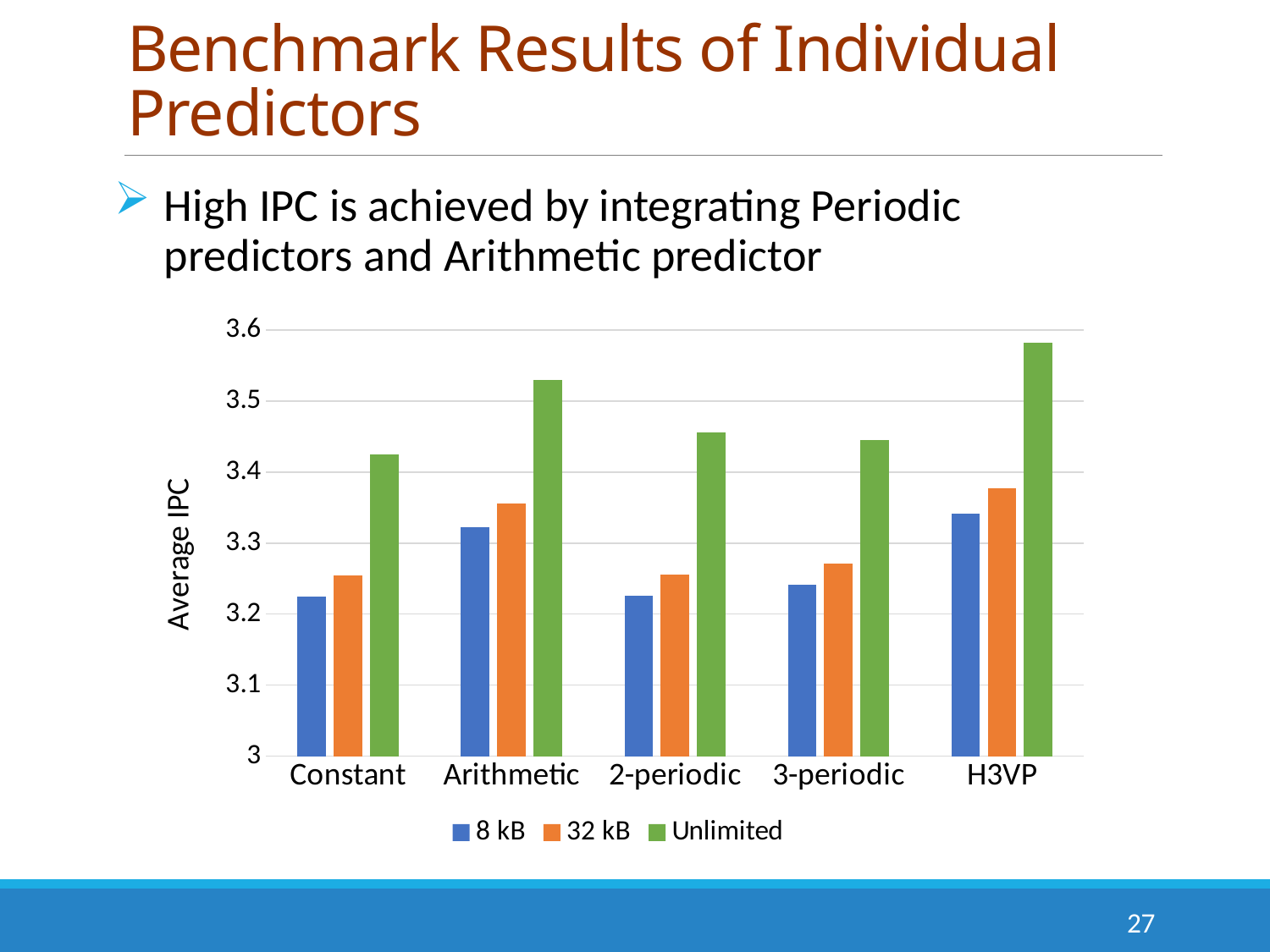
Is the 32 kB value for H3VP greater or less than 3.4? less Is the 8 kB value for Arithmetic greater or less than 3.3? greater What is the label of the vertical axis? Average IPC Is the Unlimited value for H3VP greater or less than 3.5? greater Which is larger, the 8 kB value for Arithmetic or the 8 kB value for Constant? Arithmetic How many series does the legend list? 3 Which series is shown in green in the legend? Unlimited Which is larger, the Unlimited value for H3VP or the Unlimited value for Arithmetic? H3VP What kind of chart is shown on the slide? bar chart Which predictor has the highest Unlimited value? H3VP How many predictor categories are shown on the x axis? 5